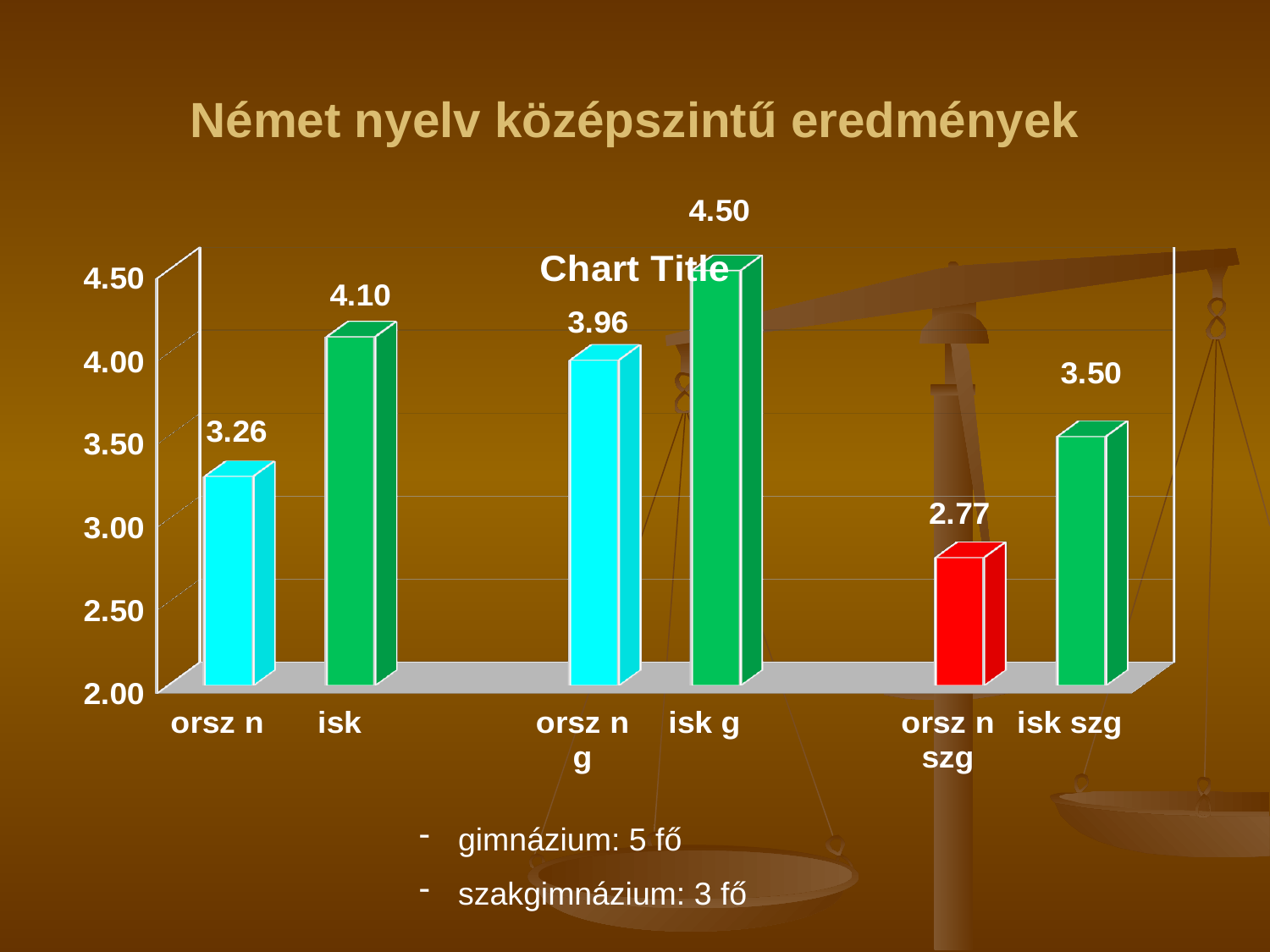
Which category has the lowest value? orsz n szg Which is larger, the value for "orsz n g" or the value for "isk szg"? orsz n g What is the value for "orsz n g"? 3.96 What is the value for "isk"? 4.10 What is the difference between the values for "isk szg" and "orsz n szg"? 0.73 Which category has the highest value? isk g How many bars are shown in the chart? 6 What colour is the bar for "orsz n szg"? red What is the difference between the values for "isk" and "orsz n"? 0.84 What kind of chart is shown on the slide? bar chart What is the value for "orsz n szg"? 2.77 What is the value for "isk g"? 4.50